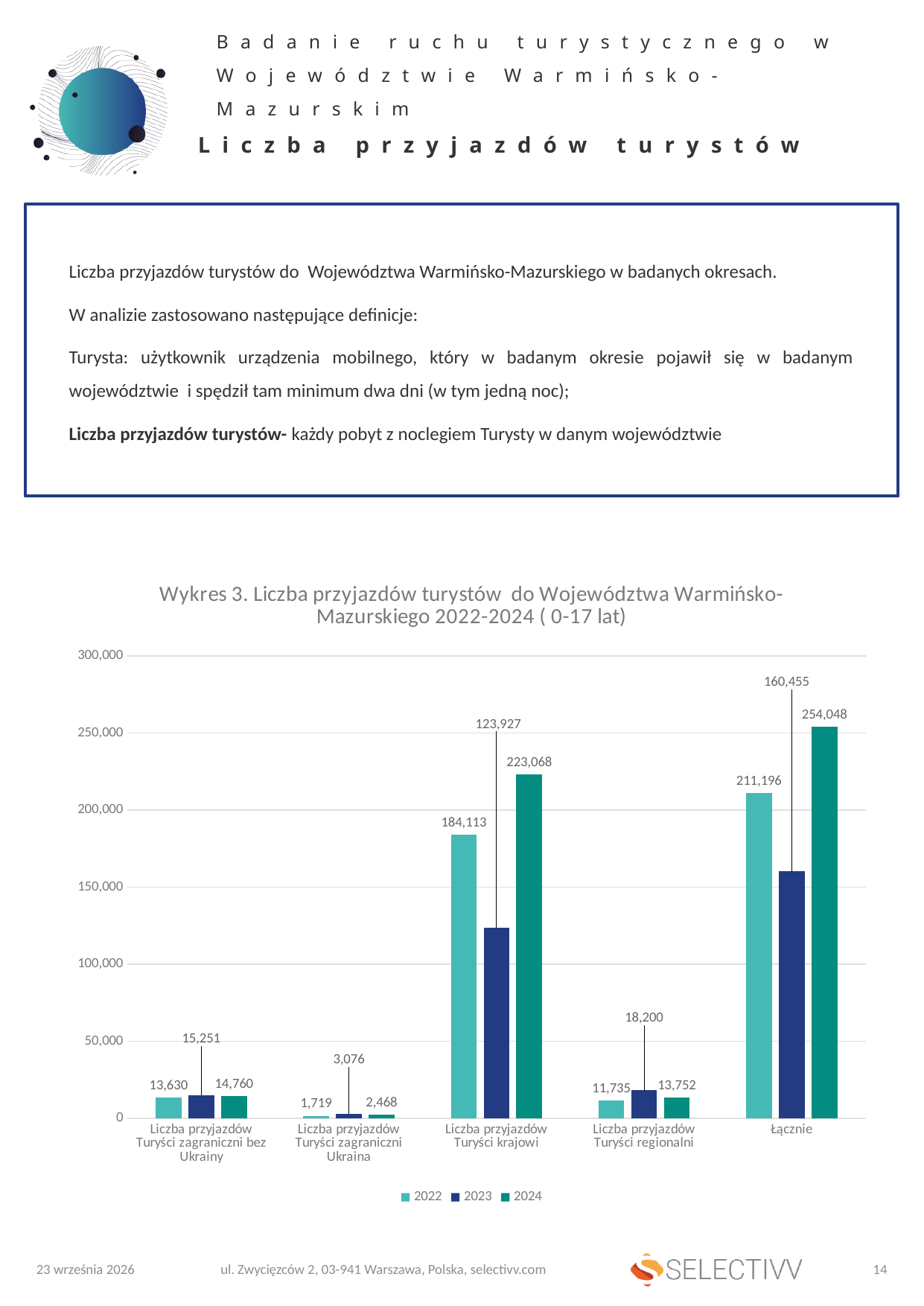
What is the value for 2022 in the 'Liczba przyjazdów Turyści zagraniczni Ukraina' category? 1,719 What is the difference between the 2024 and 2022 values in the 'Łącznie' category? 42,852 Which year has the lowest value in the 'Łącznie' category? 2023 Which year has the highest value in the 'Liczba przyjazdów Turyści regionalni' category? 2023 What type of chart is shown on the slide? bar chart What is the title of the chart? Wykres 3. Liczba przyjazdów turystów do Województwa Warmińsko-Mazurskiego 2022-2024 ( 0-17 lat) How many series does the legend list? 3 Is the 2022 value for 'Liczba przyjazdów Turyści krajowi' greater or less than 150,000? greater Which is larger: the 2022 value or the 2024 value for 'Liczba przyjazdów Turyści zagraniczni bez Ukrainy'? 2024 What is the value for 2023 in the 'Liczba przyjazdów Turyści krajowi' category? 123,927 How many categories are shown on the x axis? 5 What is the value for 2024 in the 'Łącznie' category? 254,048